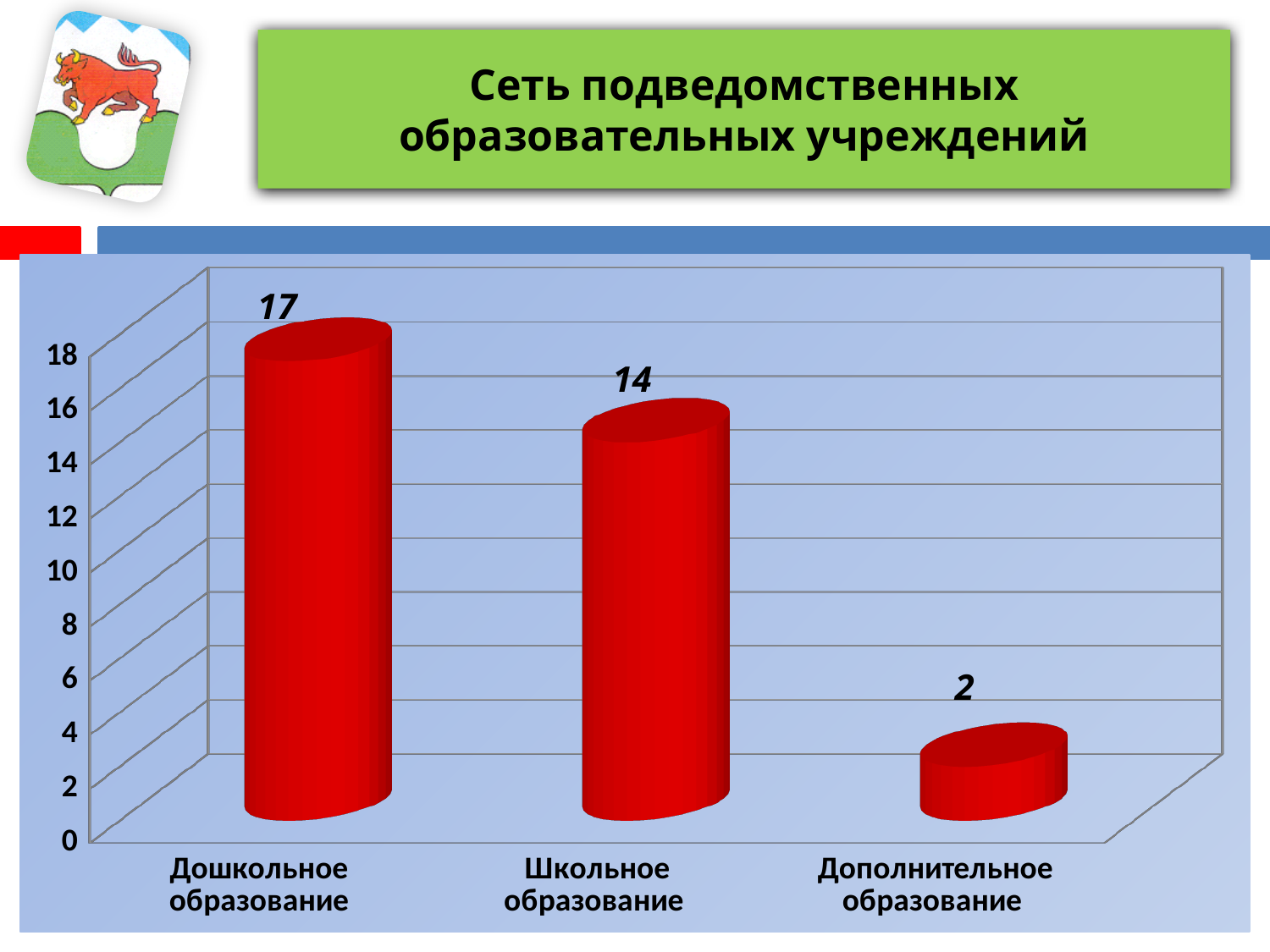
Which category has the lowest value? Дополнительное образование What is the difference between the values for Школьное образование and Дополнительное образование? 12 What is the value for Дошкольное образование? 17 What is the title of the slide? Сеть подведомственных образовательных учреждений Is the value for Школьное образование greater or less than 10? greater What is the value for Школьное образование? 14 How many categories are shown in the chart? 3 Which category has the highest value? Дошкольное образование What kind of chart is shown on the slide? bar chart Which is larger, the value for Школьное образование or Дополнительное образование? Школьное образование What is the value for Дополнительное образование? 2 What is the difference between the values for Дошкольное образование and Школьное образование? 3